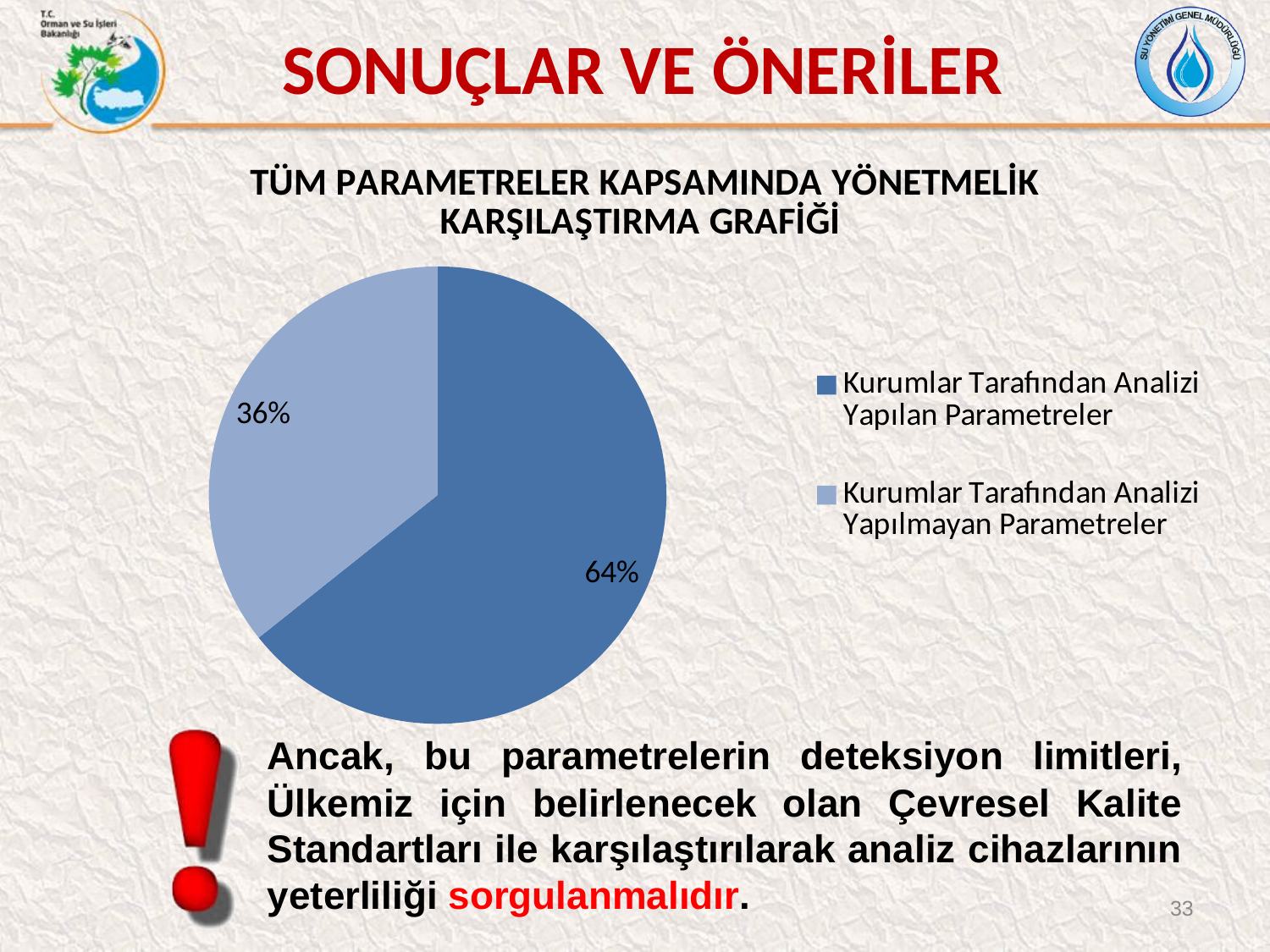
Which is larger: the share of parameters analysed by institutions or the share not analysed? Kurumlar Tarafından Analizi Yapılan Parametreler Which slice of the pie is the smallest? Kurumlar Tarafından Analizi Yapılmayan Parametreler How many entries does the legend list? 2 Which slice of the pie is the largest? Kurumlar Tarafından Analizi Yapılan Parametreler What is the difference in percentage points between the two slices of the pie? 28 What share of the pie is labelled 'Kurumlar Tarafından Analizi Yapılmayan Parametreler'? 36% What share of the pie is labelled 'Kurumlar Tarafından Analizi Yapılan Parametreler'? 64% Is the share for 'Kurumlar Tarafından Analizi Yapılan Parametreler' greater or less than 50%? greater What type of chart is shown on the slide? pie chart Which legend entry is shown in the darker blue colour? Kurumlar Tarafından Analizi Yapılan Parametreler What is the title of the chart? TÜM PARAMETRELER KAPSAMINDA YÖNETMELİK KARŞILAŞTIRMA GRAFİĞİ How many slices does the pie chart have? 2